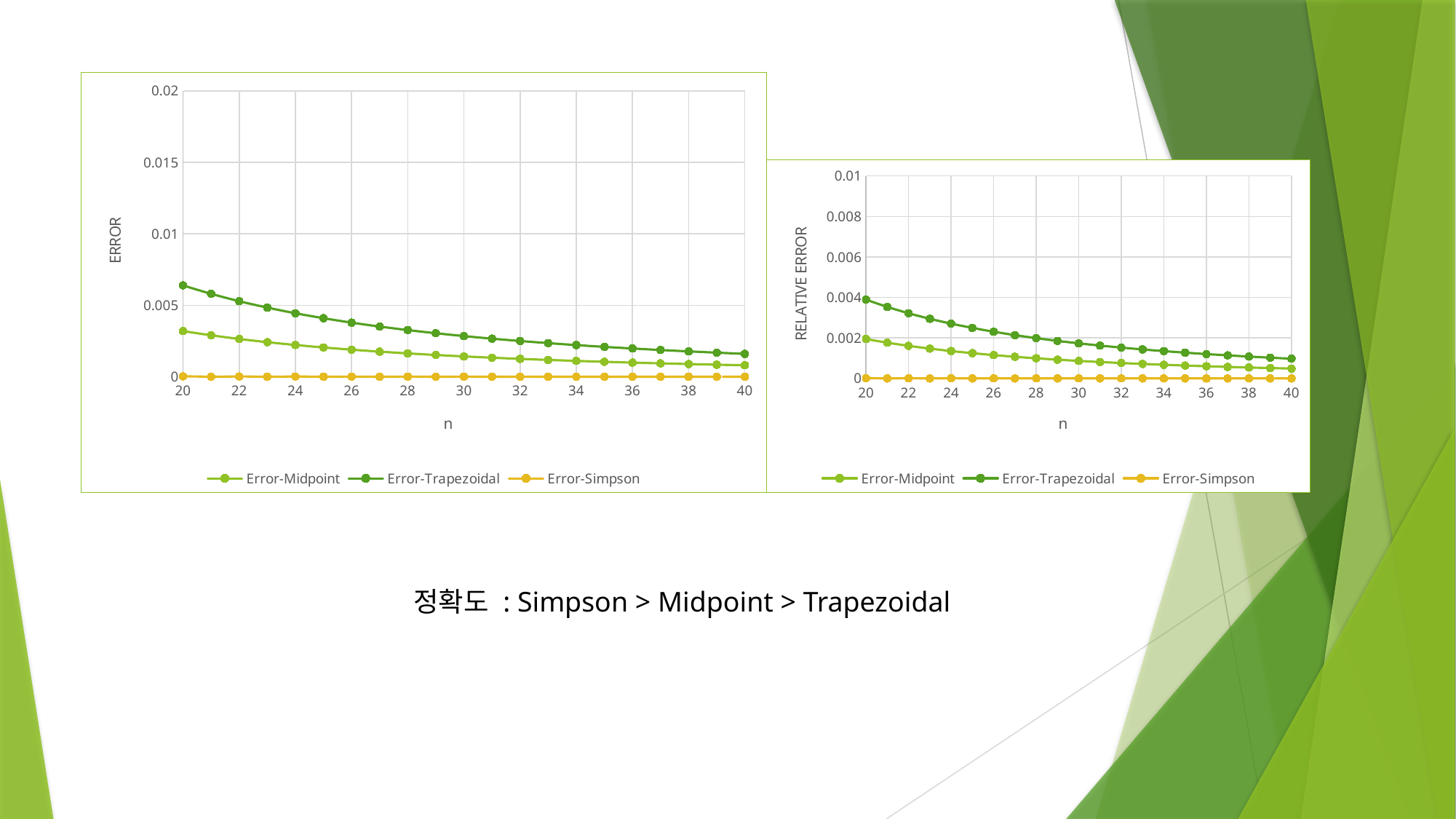
In the left chart (ERROR), which series has the highest value at n = 20? Error-Trapezoidal In the right chart (RELATIVE ERROR), which is larger at n = 30: Error-Trapezoidal or Error-Midpoint? Error-Trapezoidal In the left chart (ERROR), is the value of Error-Midpoint at n = 20 greater or less than 0.005? less What kind of chart is the left chart (y axis labelled ERROR)? line chart What is the x-axis label of the right chart (RELATIVE ERROR)? n In the right chart (RELATIVE ERROR), does the Error-Midpoint series rise or fall as n increases? fall In the left chart (ERROR), is the value of Error-Trapezoidal at n = 20 greater or less than 0.005? greater In the right chart (RELATIVE ERROR), which series has the lowest values across all n? Error-Simpson How many series does the legend of the right chart (y axis labelled RELATIVE ERROR) list? 3 In the left chart (ERROR), how many n values are plotted along the x axis from 20 to 40? 21 In the left chart (ERROR), does the Error-Trapezoidal series rise or fall as n increases? fall